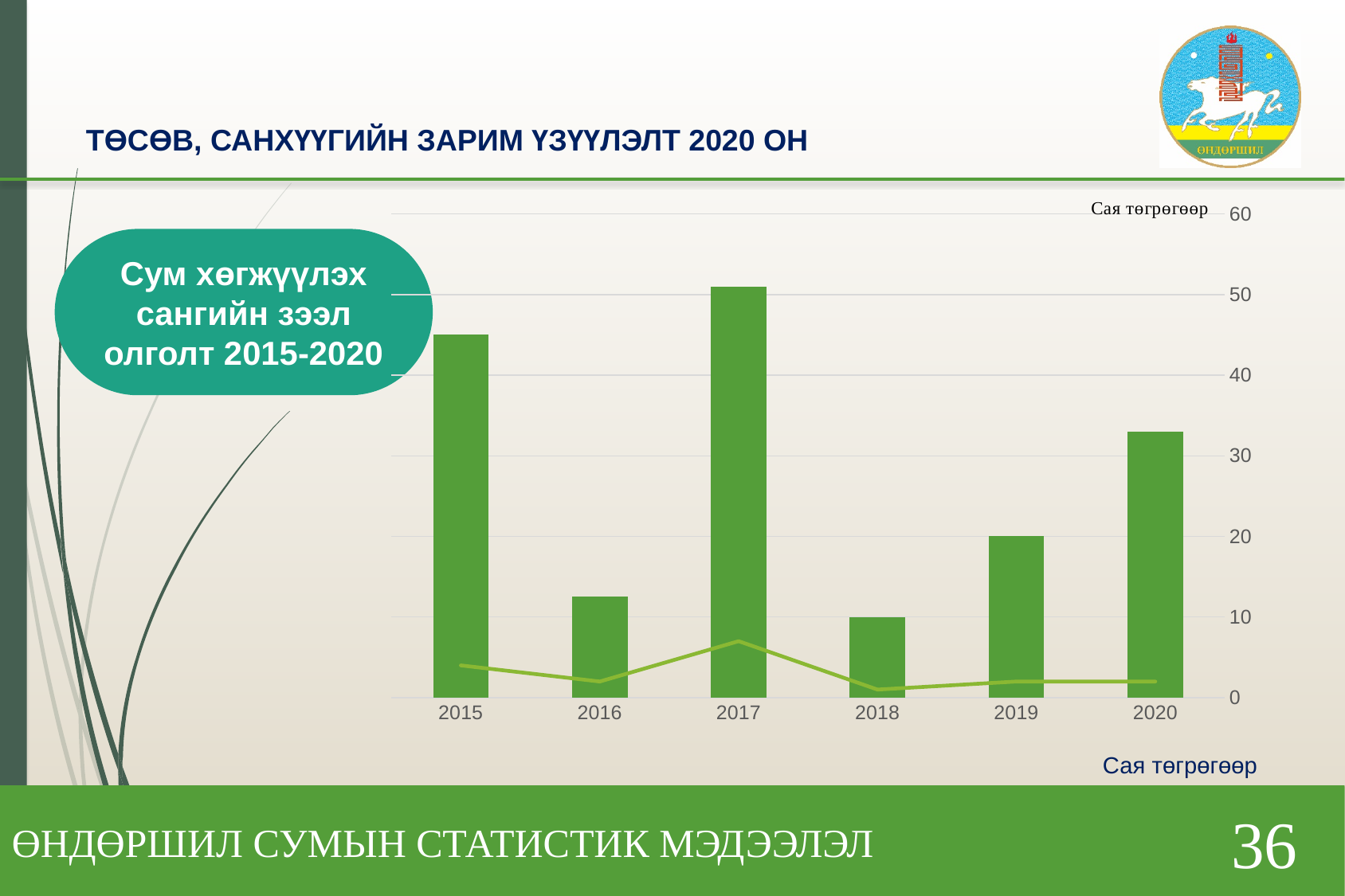
Do the bars rise or fall from 2018 to 2020? rise Is the bar for 2020 greater or less than 30? greater What kind of chart is shown on the slide? bar and line chart Is the bar for 2018 greater or less than 20? less Is the bar for 2015 greater or less than 40? greater Which year has the lowest bar in the chart? 2018 Which year has the highest bar in the chart? 2017 Which year has the larger bar, 2015 or 2020? 2015 What unit is stated for the values in the chart? Сая төгрөгөөр How many years are shown on the x axis of the chart? 6